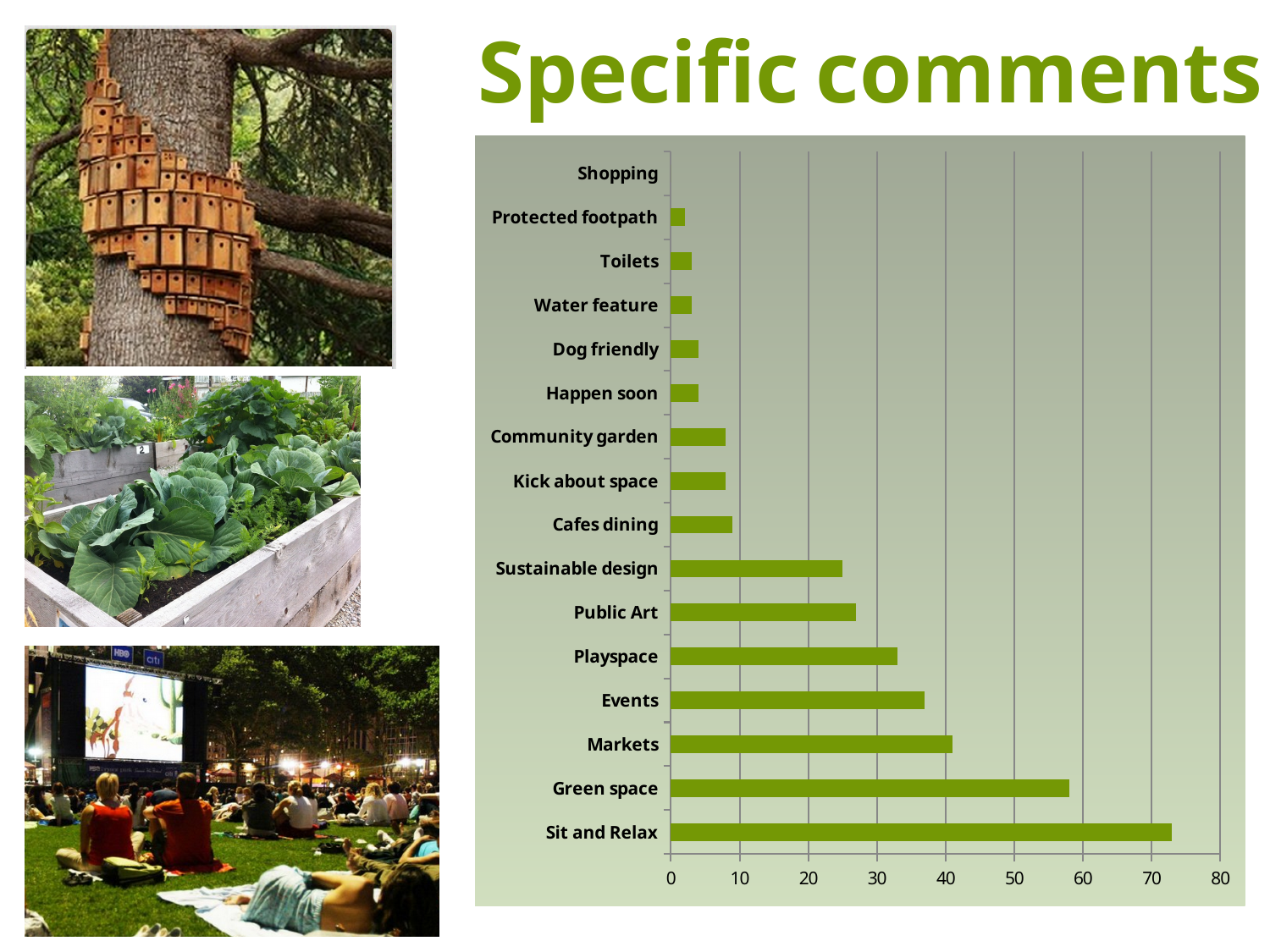
Which category has the highest value in the chart? Sit and Relax Is the value for Sit and Relax greater or less than 70? greater Which category has the lowest value in the chart? Shopping What kind of chart is shown on the slide? bar chart How many categories are shown in the chart? 16 Is the value for Events greater or less than 40? less Is the value for Cafes dining greater or less than 10? less What colour are the bars in the chart? green Which has the larger value, Green space or Markets? Green space Which has the larger value, Events or Playspace? Events